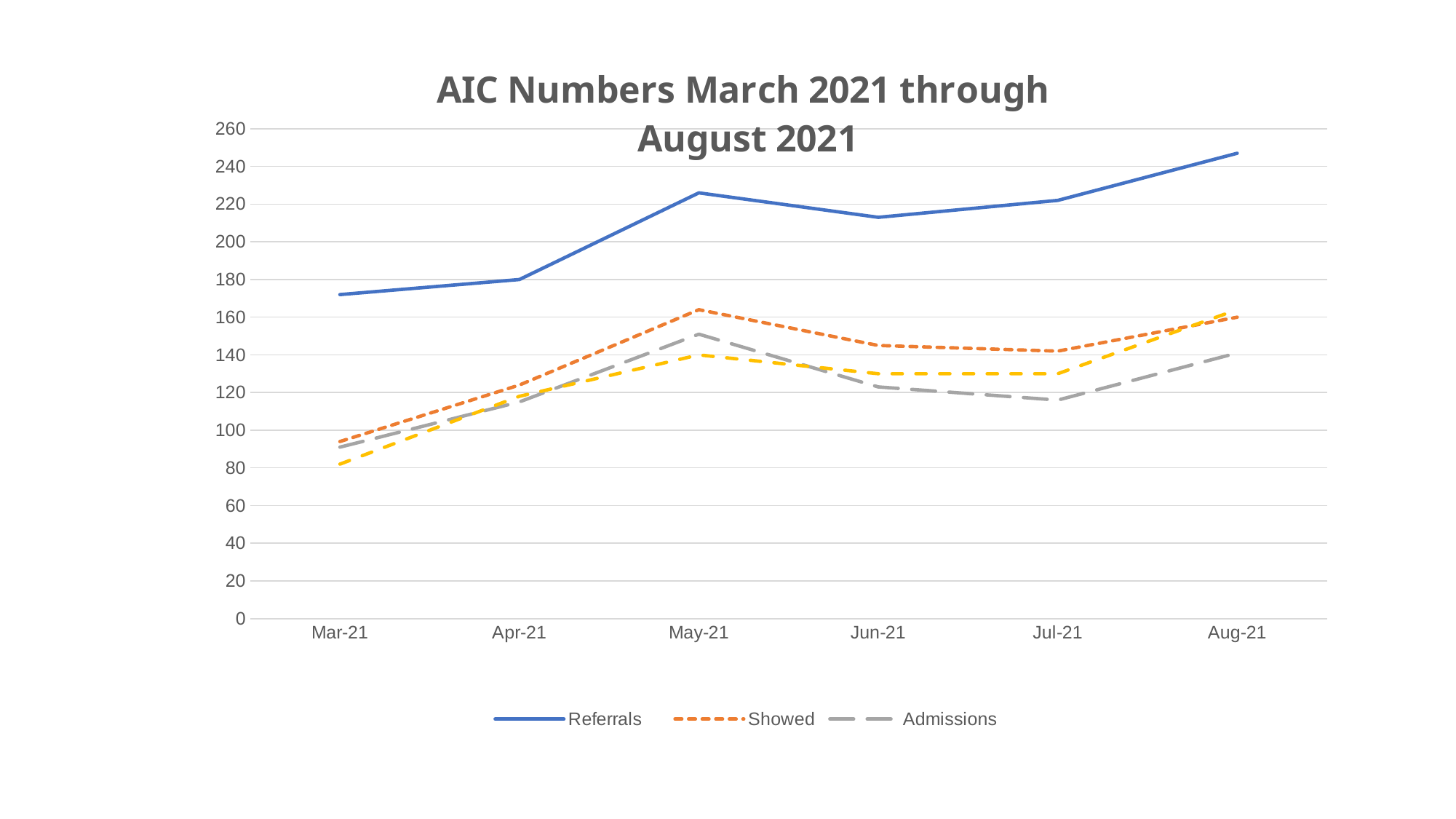
Is the Admissions value for Jul-21 greater or less than 120? less In which month is the Admissions value highest? May-21 What is the title of the chart? AIC Numbers March 2021 through August 2021 Which is larger in Jun-21, the Showed value or the Admissions value? Showed How many months are plotted along the x axis? 6 In which month is the Referrals value lowest? Mar-21 What kind of chart is shown on the slide? line chart In which month is the Referrals value highest? Aug-21 How many series does the legend list? 3 Is the Referrals value for Mar-21 greater or less than 180? less In which month is the Showed value highest? May-21 Is the Referrals value for Aug-21 greater or less than 240? greater